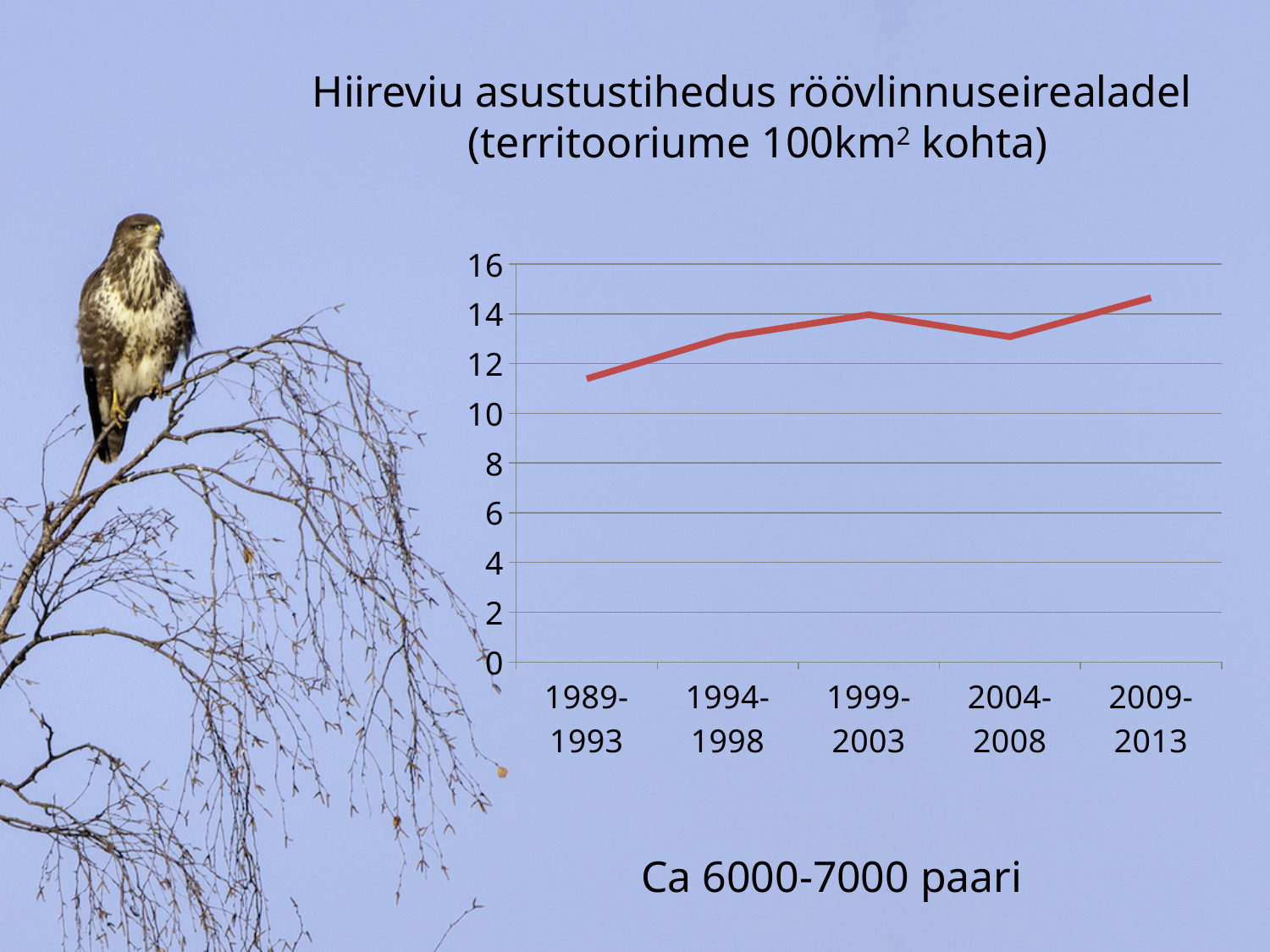
Is the value for 2009-2013 greater or less than 14? greater How many time periods are plotted on the x axis of the chart? 5 Is the value for 1994-1998 greater or less than 12? greater Is the value for 2004-2008 greater or less than 14? less Overall, do the values rise or fall from 1989-1993 to 2009-2013? rise Which period has the highest value in the chart? 2009-2013 Which is larger, the value for 2004-2008 or the value for 2009-2013? 2009-2013 What is the maximum value shown on the y axis of the chart? 16 Which is larger, the value for 1989-1993 or the value for 1999-2003? 1999-2003 What kind of chart is shown on the slide? line chart Which period has the lowest value in the chart? 1989-1993